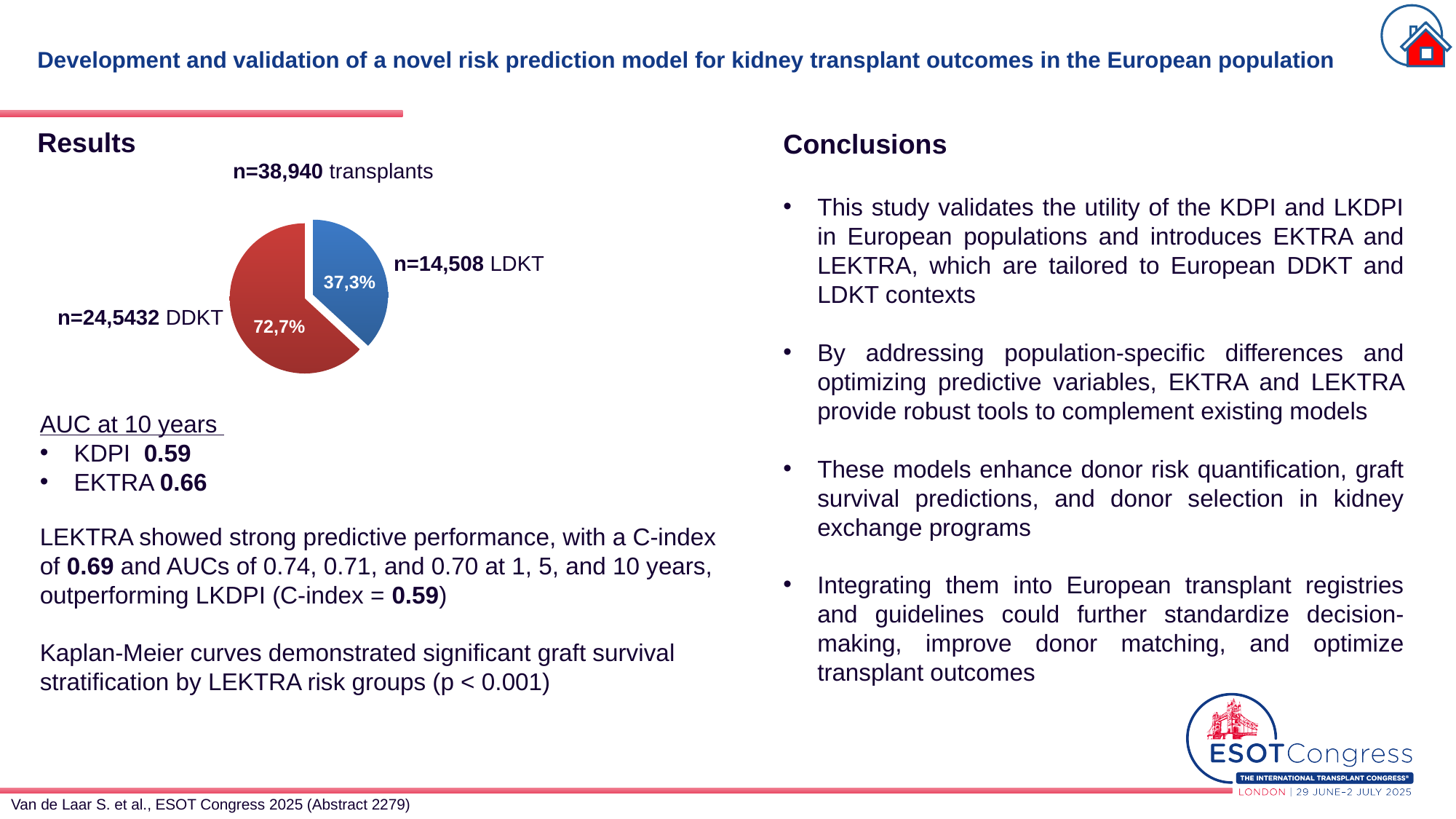
What is the number of transplants (n) labelled for LDKT on the pie chart? n=14,508 What colour is the DDKT slice of the pie chart? Red What percentage is shown for the LDKT slice of the pie chart? 37,3% What is the difference in percentage points between the DDKT and LDKT slices as labelled on the pie chart? 35,4 percentage points How many slices does the pie chart have? 2 What percentage is shown for the DDKT slice of the pie chart? 72,7% Which is larger in the pie chart, the DDKT slice or the LDKT slice? DDKT What total number of transplants is stated above the pie chart? n=38,940 transplants Which slice of the pie chart is the smallest? LDKT Which slice of the pie chart is the largest? DDKT What is the number of transplants (n) labelled for DDKT on the pie chart? n=24,5432 What kind of chart is shown on the slide? Pie chart